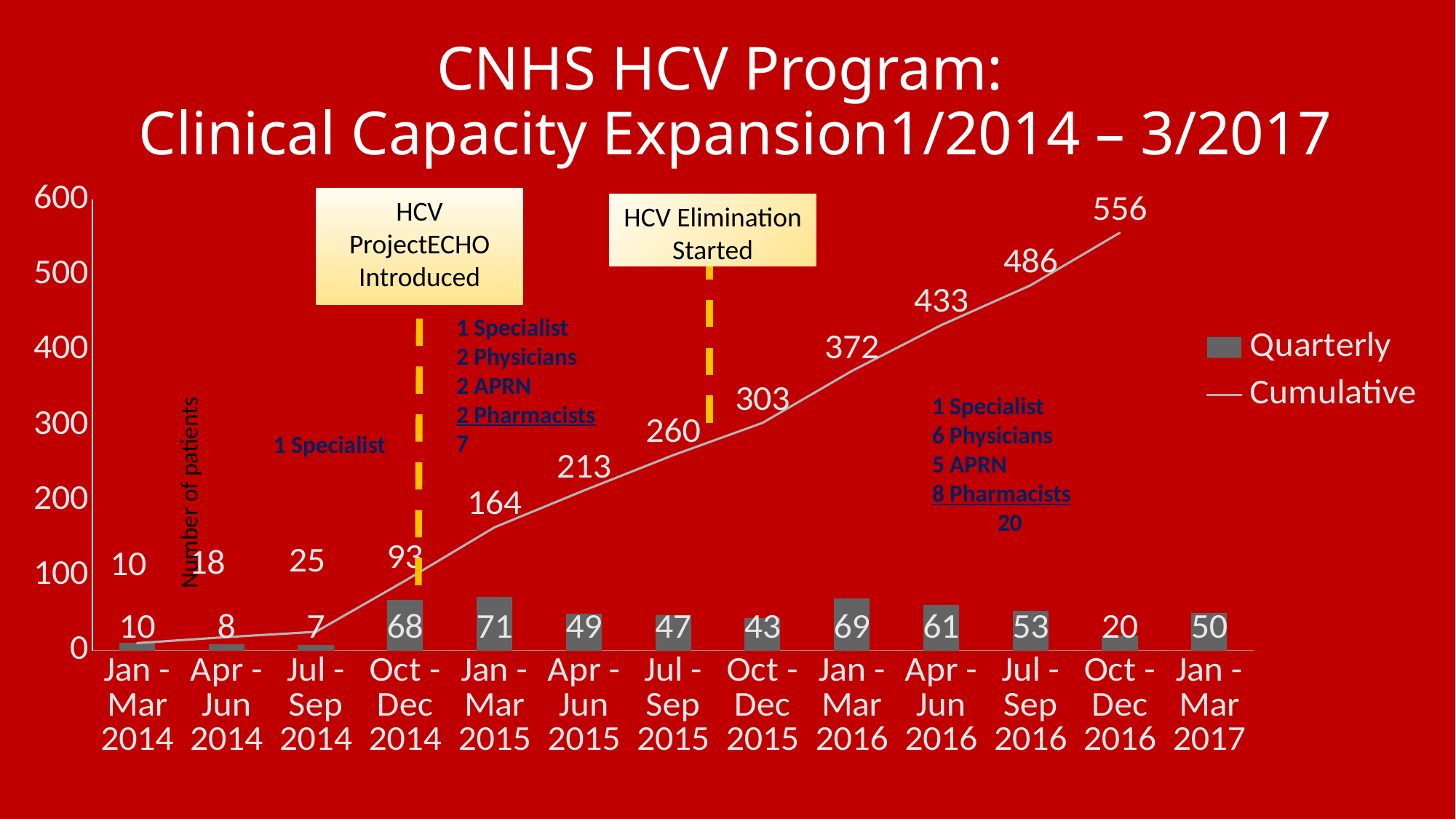
How many quarters are shown on the x axis? 13 Which quarter has the highest Quarterly value? Jan - Mar 2015 What is the Cumulative value for Oct - Dec 2015? 303 What is the Cumulative value for Jan - Mar 2015? 164 Does the Cumulative line rise or fall from Jan - Mar 2014 to the end of the x axis? Rise What is the Quarterly value for Jan - Mar 2016? 69 Which is larger, the Quarterly value for Apr - Jun 2016 or for Jul - Sep 2016? Apr - Jun 2016 What is the Quarterly value for Oct - Dec 2014? 68 What is the difference between the Quarterly values for Jan - Mar 2015 and Apr - Jun 2015? 22 Which quarter has the lowest Quarterly value? Jul - Sep 2014 How many series does the legend list? 2 What kind of chart is this? Combined bar and line chart